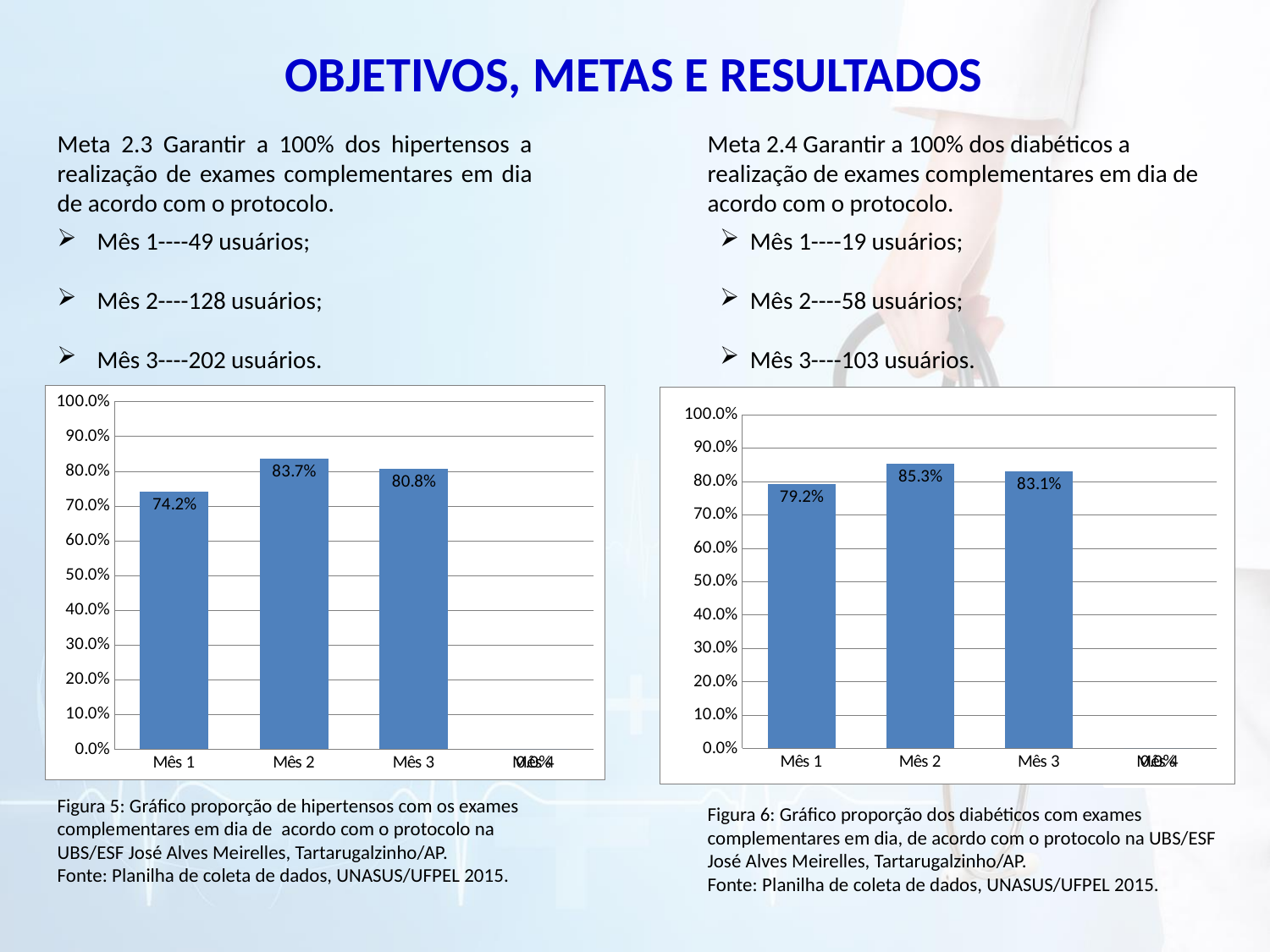
In the right chart (Figura 6, diabéticos), what is the value for Mês 1? 79.2% In the left chart (Figura 5, hipertensos), is the value for Mês 1 greater or less than 80.0%? less In the left chart (Figura 5, hipertensos), what is the value for Mês 2? 83.7% In the left chart (Figura 5, hipertensos), what is the value for Mês 1? 74.2% What kind of chart is the right chart (Figura 6, diabéticos)? bar chart In the left chart (Figura 5, hipertensos), what is the value for Mês 3? 80.8% In the left chart (Figura 5, hipertensos), which month has the highest value? Mês 2 In the right chart (Figura 6, diabéticos), which is larger, the value for Mês 2 or Mês 3? Mês 2 In the right chart (Figura 6, diabéticos), what is the value for Mês 2? 85.3% In the left chart (Figura 5, hipertensos), what is the difference between the values for Mês 2 and Mês 1? 9.5% In the right chart (Figura 6, diabéticos), what is the value for Mês 3? 83.1%